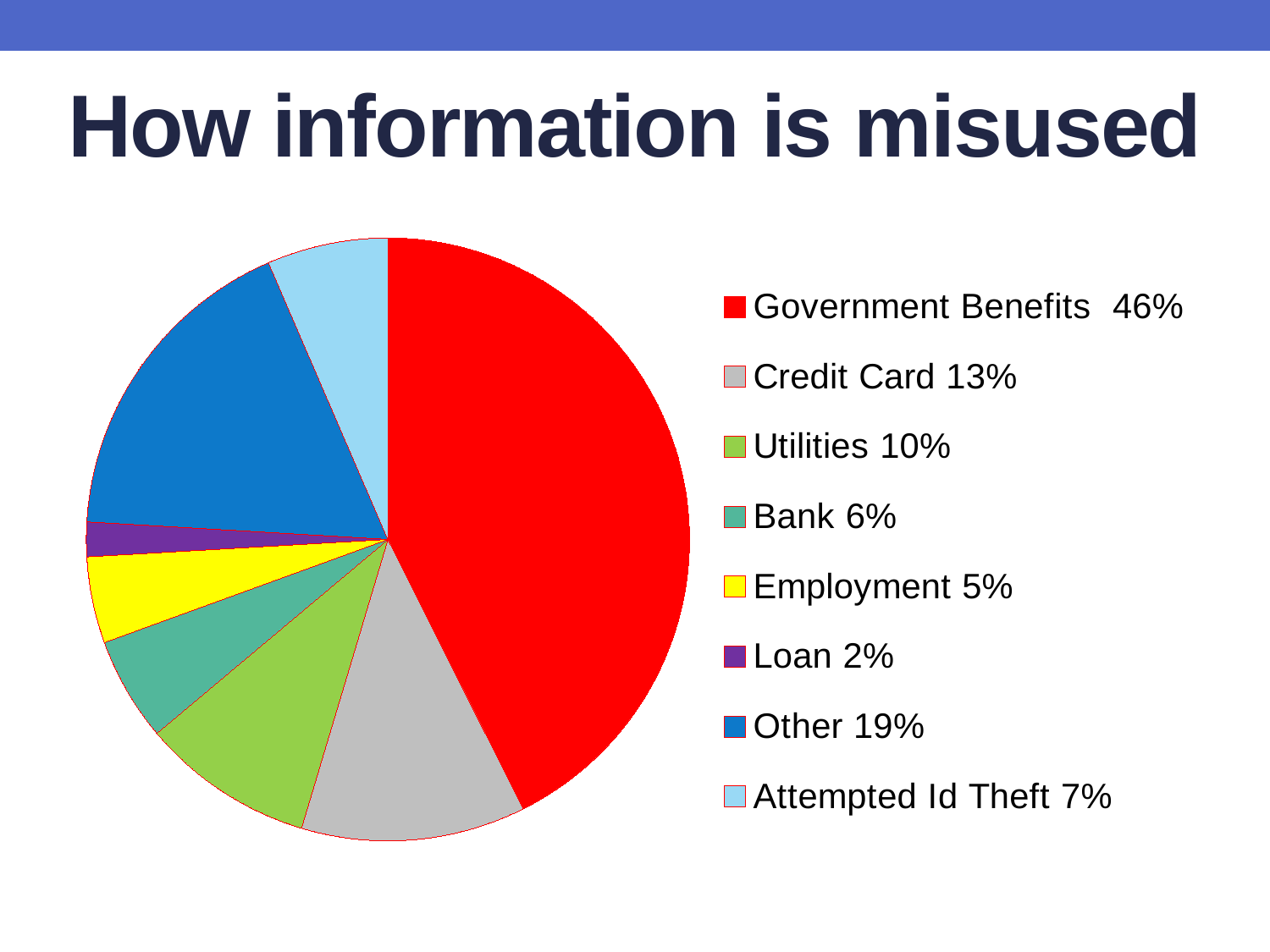
How many categories does the pie chart have? 8 What is the difference in percentage points between Other and Utilities? 9 What is the title of the slide containing the chart? How information is misused What percentage is shown for Attempted Id Theft? 7% Which is larger, the share for Bank or the share for Employment? Bank What kind of chart is shown on the slide? pie chart What percentage is shown for Credit Card? 13% What colour is the slice for Employment? yellow What share of the pie does Government Benefits represent? 46% Which category has the largest slice of the pie? Government Benefits What is the difference in percentage points between Government Benefits and Credit Card? 33 Which category has the smallest slice of the pie? Loan